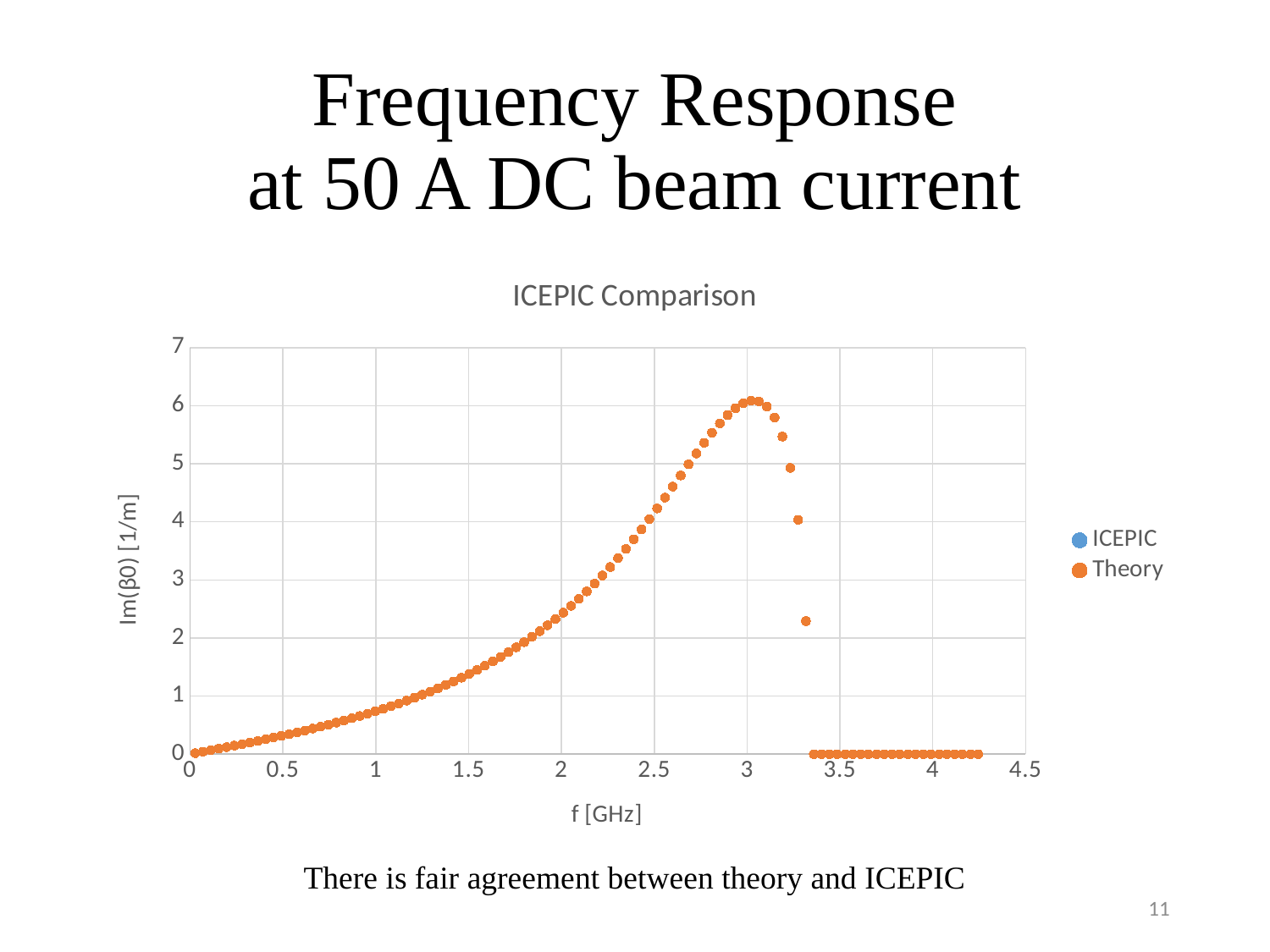
Is the Theory value at f = 1.5 GHz greater or less than 1? greater Which is larger, the Theory value at f = 2.5 GHz or at f = 1 GHz? f = 2.5 GHz What is the label of the x axis? f [GHz] Is the Theory value at f = 1 GHz greater or less than 1? less What kind of chart is shown on the slide? scatter chart Is the peak value of the Theory series greater or less than 7? less How many series does the chart legend list? 2 What is the title of the chart? ICEPIC Comparison What is the Theory value at f = 4 GHz? 0 Do the Theory values rise or fall as f increases from 0 to 3 GHz? rise